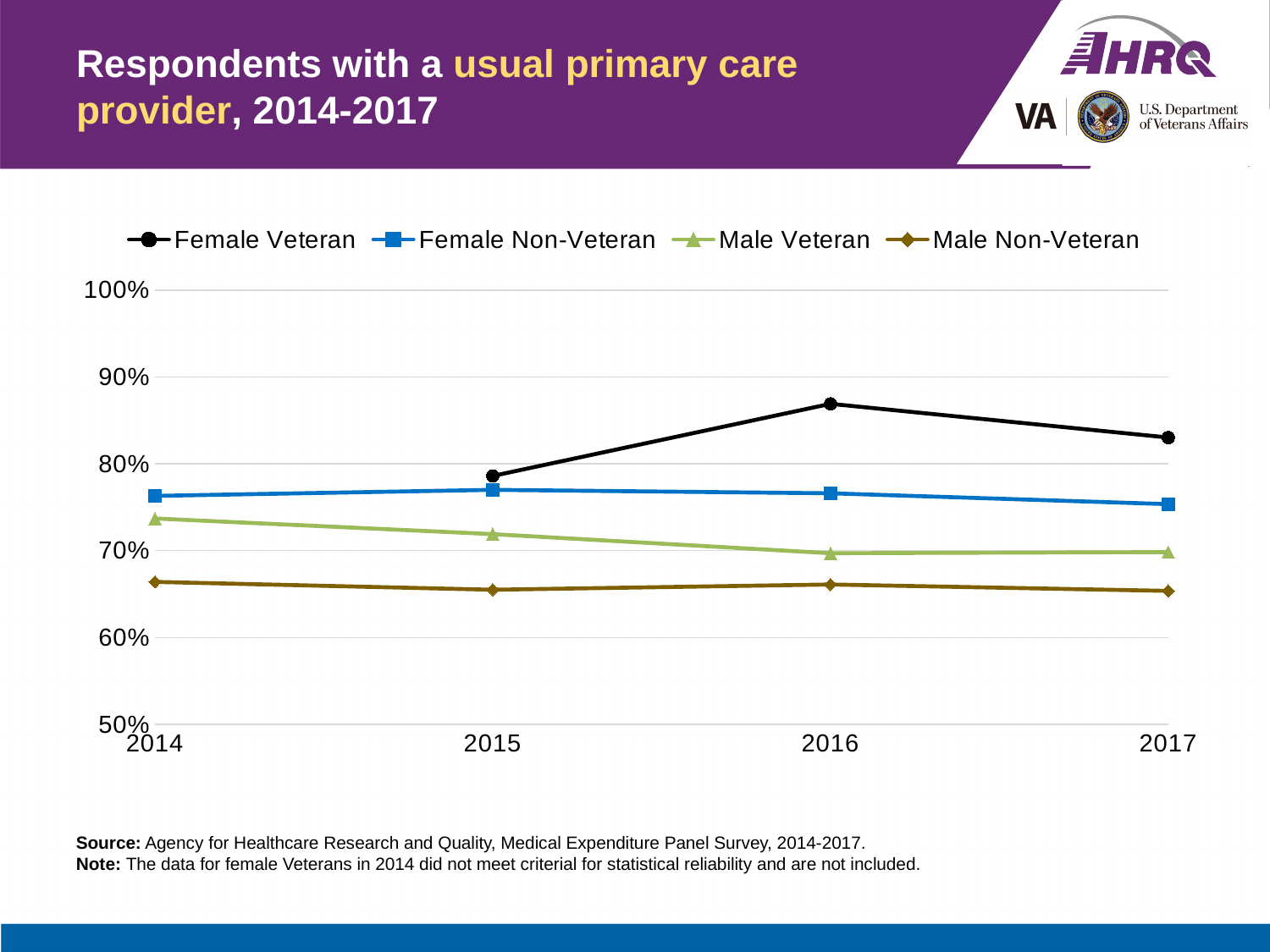
Is the value for Female Veteran in 2016 greater or less than 80%? greater Which series has no data point plotted for 2014? Female Veteran What kind of chart is shown on the slide? line chart Is the value for Female Non-Veteran in 2015 greater or less than 80%? less Does the Male Veteran line rise or fall from 2014 to 2016? fall Which series has the highest value in 2016? Female Veteran How many series does the legend list? 4 Which series has the lowest value in 2017? Male Non-Veteran Is the value for Male Veteran in 2014 greater or less than 70%? greater In 2015, which is larger: the value for Male Veteran or the value for Male Non-Veteran? Male Veteran How many years are shown on the x axis? 4